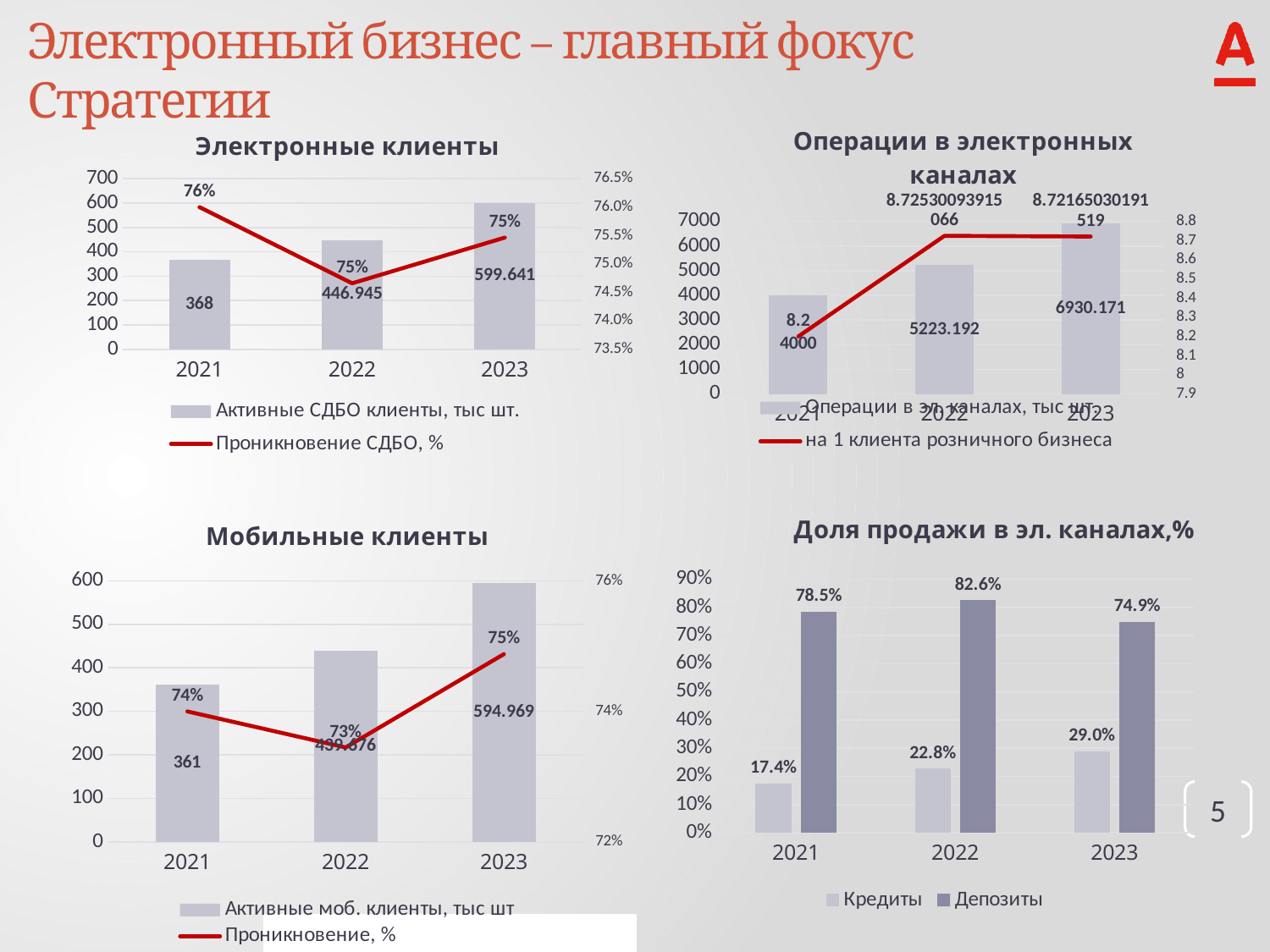
In the 'Мобильные клиенты' chart, what is the penetration value for 2023? 75% In the 'Доля продажи в эл. каналах,%' chart, which year has the lowest value for Кредиты? 2021 In the 'Операции в электронных каналах' chart, which year has the highest bar value? 2023 In the 'Операции в электронных каналах' chart, what is the line value (на 1 клиента розничного бизнеса) for 2021? 8.2 In the 'Электронные клиенты' chart, what is the penetration (Проникновение СДБО, %) value for 2021? 76% In the 'Операции в электронных каналах' chart, what is the bar value for 2022? 5223.192 In the 'Доля продажи в эл. каналах,%' chart, what is the value for Депозиты in 2022? 82.6% In the 'Электронные клиенты' chart, what is the value of the bar for 2023? 599.641 In the 'Доля продажи в эл. каналах,%' chart, do the Кредиты values rise or fall from 2021 to 2023? rise In the 'Мобильные клиенты' chart, what is the bar value for 2021? 361 In the 'Электронные клиенты' chart, what is the difference between the bar values for 2023 and 2021? 231.641 In the 'Доля продажи в эл. каналах,%' chart, how many series does the legend list? 2